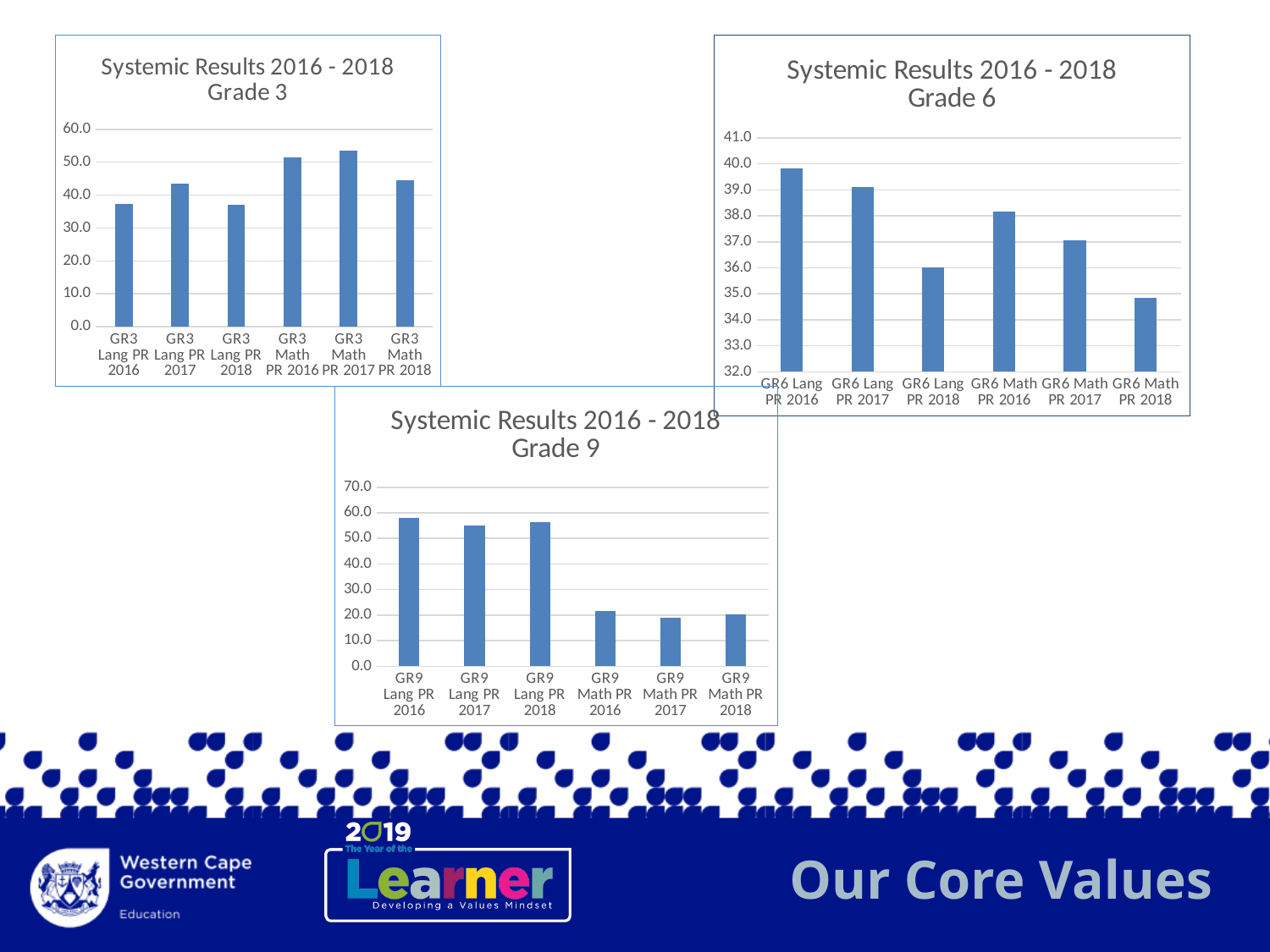
On the Grade 9 chart, which category has the highest value? GR9 Lang PR 2016 On the Grade 6 chart, do the GR6 Lang PR values rise or fall from 2016 to 2018? fall On the Grade 9 chart, which is larger, GR9 Lang PR 2016 or GR9 Math PR 2016? GR9 Lang PR 2016 On the Grade 6 chart, which category has the lowest value? GR6 Math PR 2018 What kind of chart is the Grade 6 chart? bar chart How many categories are shown on the Grade 9 chart? 6 On the Grade 3 chart, which category has the highest value? GR3 Math PR 2017 On the Grade 6 chart, which category has the highest value? GR6 Lang PR 2016 On the Grade 3 chart, is the value for GR3 Lang PR 2017 greater or less than 40.0? greater On the Grade 6 chart, is the value for GR6 Lang PR 2018 greater or less than 37.0? less On the Grade 3 chart, which is larger, GR3 Math PR 2016 or GR3 Lang PR 2016? GR3 Math PR 2016 On the Grade 9 chart, is the value for GR9 Math PR 2016 greater or less than 30.0? less